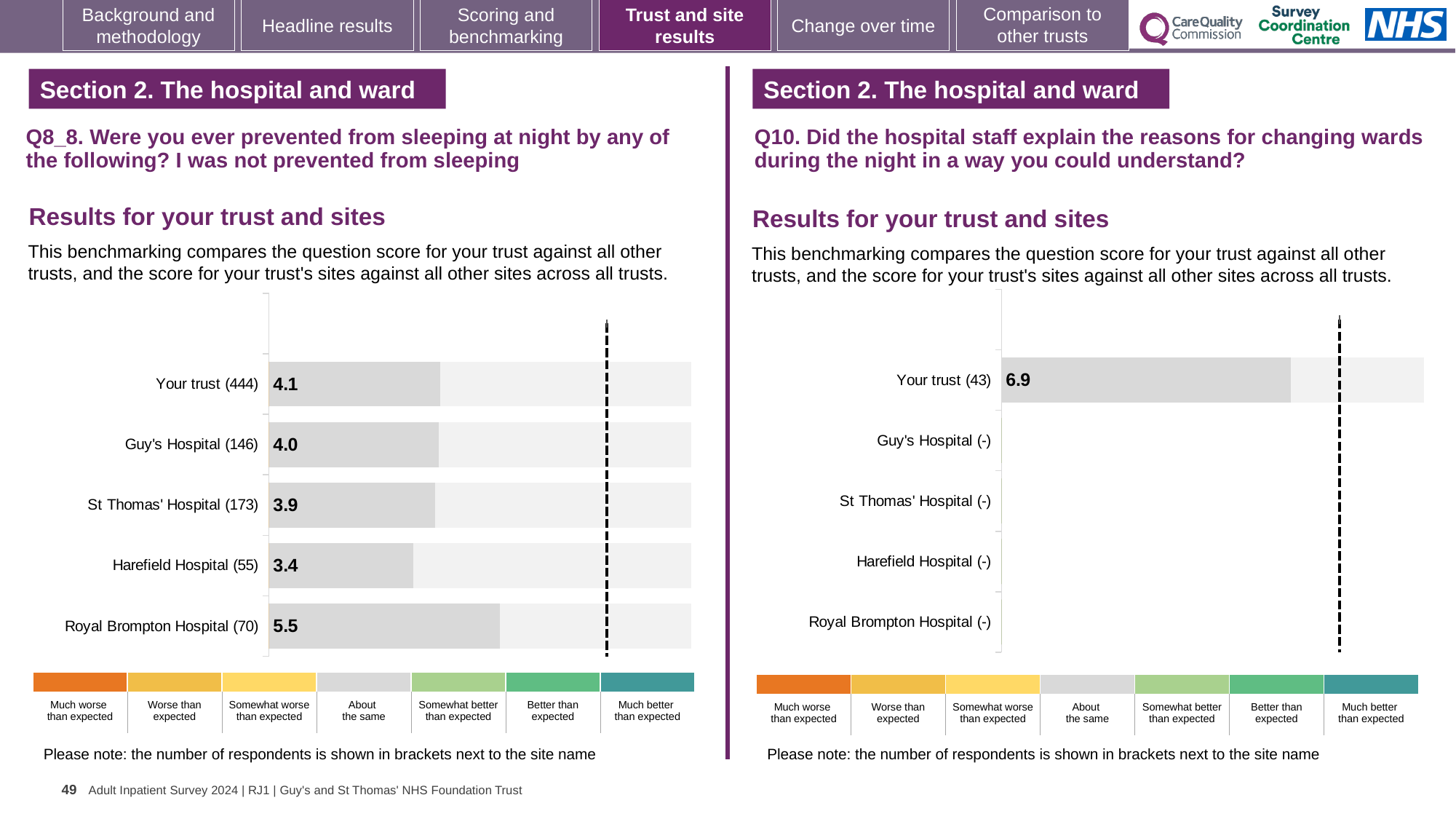
In the right chart (Q10), what is the score for Your trust? 6.9 In the left chart (Q8_8), how many bars are plotted? 5 What kind of chart is shown on the left (Q8_8)? Bar chart In the left chart (Q8_8), what is the score for Your trust? 4.1 In the left chart (Q8_8), what is the difference between the scores for Royal Brompton Hospital and Harefield Hospital? 2.1 In the left chart (Q8_8), which has the higher score, Guy's Hospital or St Thomas' Hospital? Guy's Hospital In the right chart (Q10), how many respondents are shown in brackets for Your trust? 43 In the left chart (Q8_8), which site has the highest score? Royal Brompton Hospital In the left chart (Q8_8), what is the score for Harefield Hospital? 3.4 In the left chart (Q8_8), how many respondents are shown in brackets for St Thomas' Hospital? 173 In the left chart (Q8_8), which site has the lowest score? Harefield Hospital In the left chart (Q8_8), what is the score for Royal Brompton Hospital? 5.5